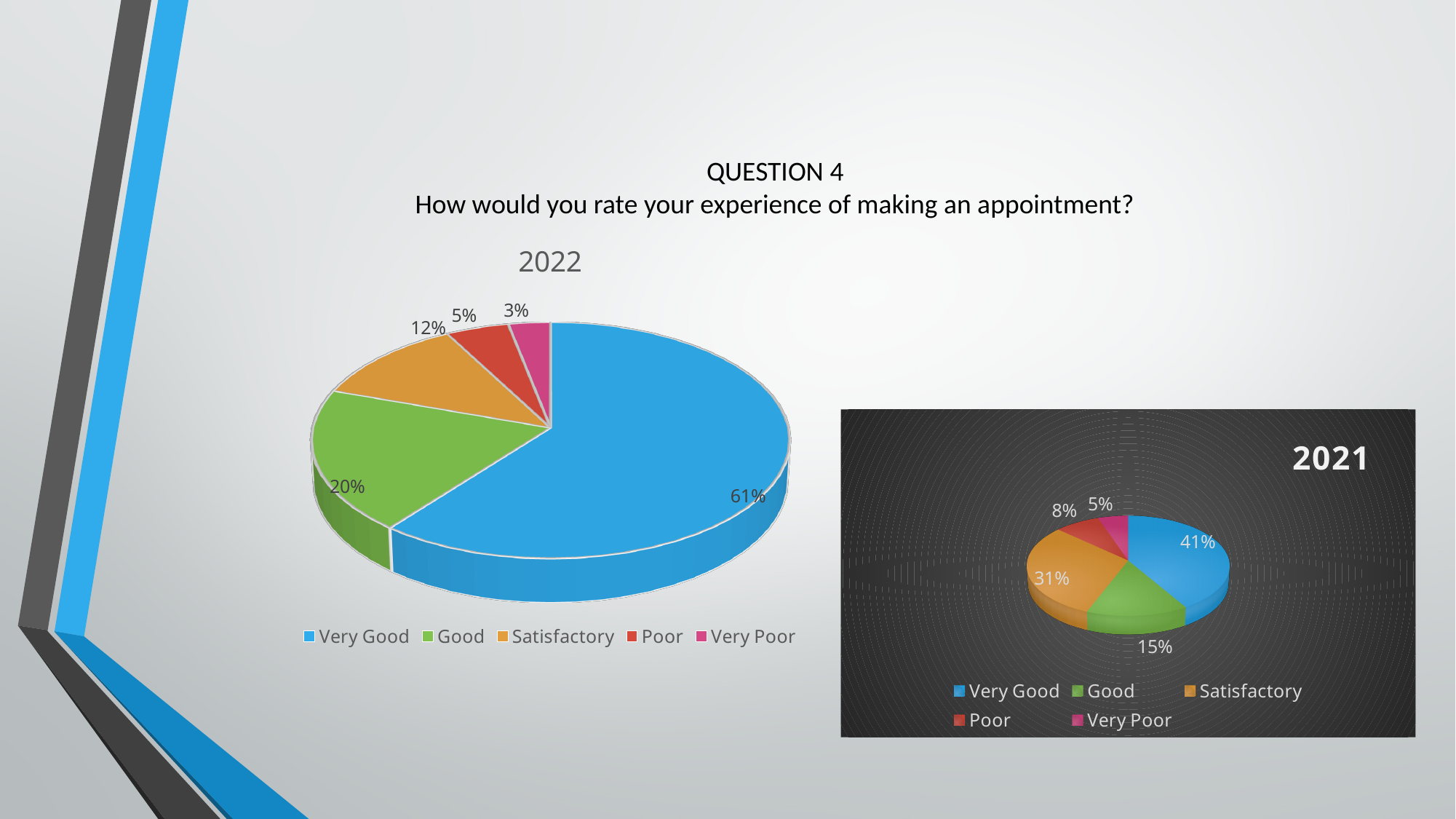
What type of chart is used for the 2021 data? Pie chart How many categories does the 2022 pie chart show? 5 In the 2022 chart, what percentage of respondents rated their experience as Very Good? 61% In the 2022 chart, which rating has the largest share? Very Good In the 2021 chart, which rating has the smallest share? Very Poor In the 2022 chart, what percentage of respondents rated their experience as Satisfactory? 12% In the 2021 chart, what percentage of respondents rated their experience as Satisfactory? 31% What is the difference between the Very Good share in 2022 and the Very Good share in 2021? 20% In the 2022 chart, what colour represents the Poor category? Red In the 2022 chart, which rating has the smallest share? Very Poor In the 2021 chart, which is larger: the share for Satisfactory or the share for Good? Satisfactory In the 2021 chart, what percentage of respondents rated their experience as Good? 15%